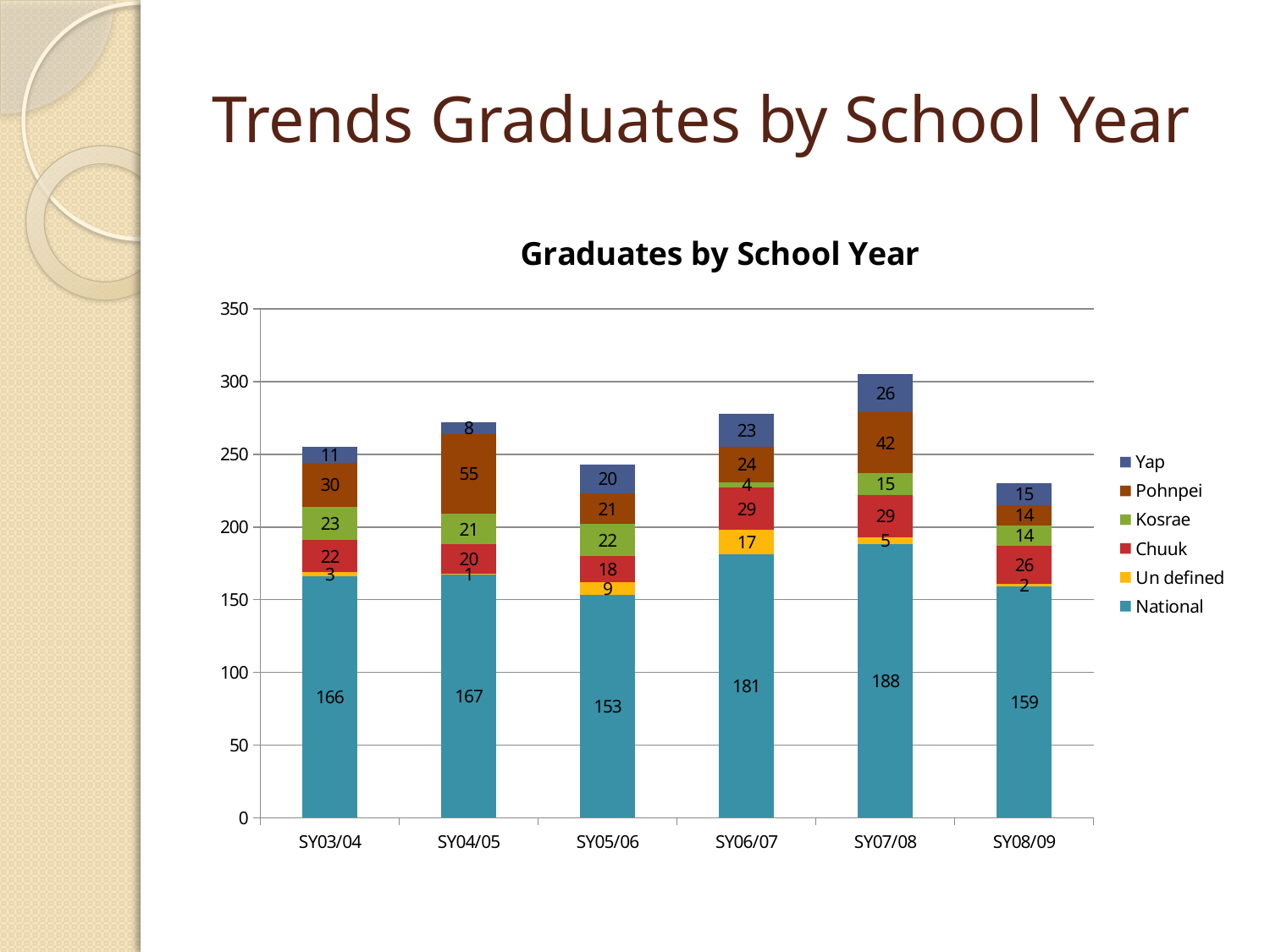
What is the Pohnpei value for SY04/05? 55 What is the National value for SY07/08? 188 Which school year has the lowest National value? SY05/06 Which school year has the highest National value? SY07/08 How many school years are shown on the x axis? 6 Which is larger, the Yap value for SY07/08 or the Yap value for SY04/05? SY07/08 What type of chart is shown on the slide? Stacked bar chart Is the total of the SY08/09 bar greater or less than 250? less What is the total of the stacked bar for SY07/08? 305 How many series does the legend list? 6 What is the difference between the National values for SY07/08 and SY05/06? 35 What is the Un defined value for SY06/07? 17